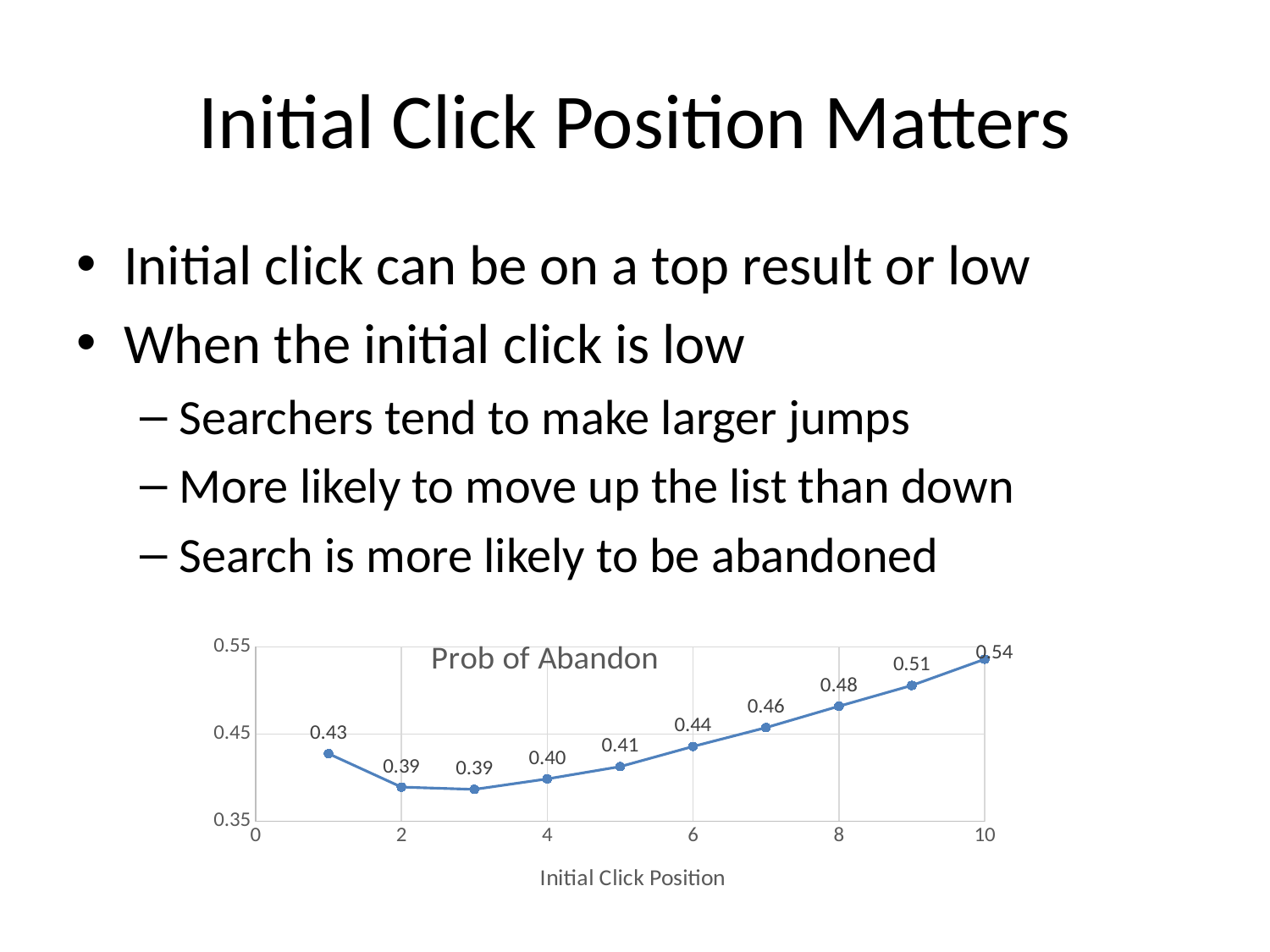
At which initial click position is the probability of abandon highest? 10 What kind of chart is shown on the slide? line chart How many data points are plotted on the chart? 10 What is the difference between the probability of abandon at position 10 and at position 1? 0.11 What is the difference between the probability of abandon at position 9 and at position 8? 0.03 What is the label of the x axis of the chart? Initial Click Position What is the probability of abandon at initial click position 7? 0.46 Does the probability of abandon rise or fall from initial click position 4 to position 10? rise What is the probability of abandon at initial click position 10? 0.54 What is the probability of abandon at initial click position 1? 0.43 Which has a higher probability of abandon, initial click position 6 or position 4? position 6 What is the title of the chart? Prob of Abandon